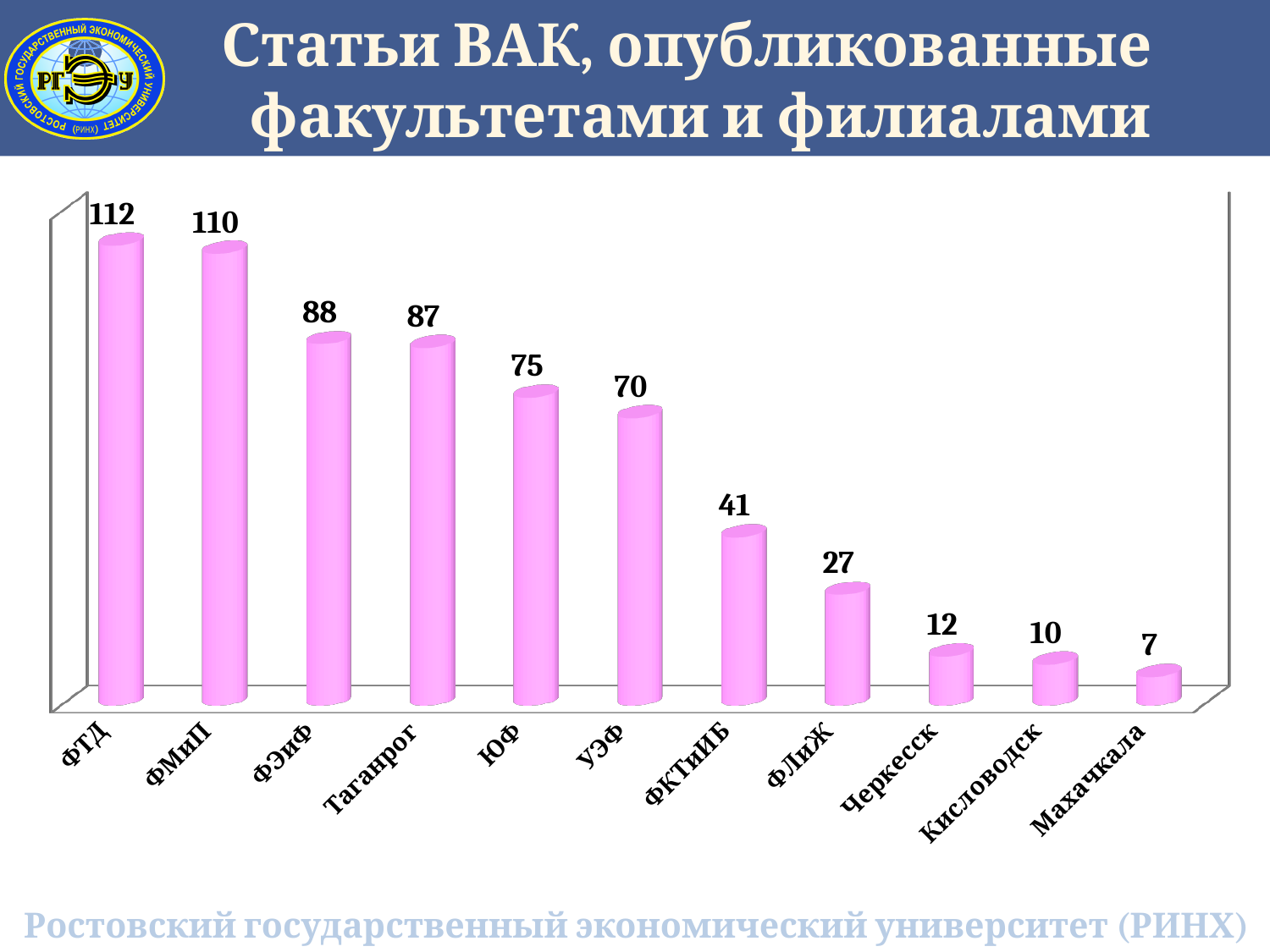
Do the values rise or fall from left to right along the x axis? fall Which category has the lowest value? Махачкала What is the value for ФТД? 112 Which is larger, the value for ФЛиЖ or the value for Черкесск? ФЛиЖ What is the value for ФКТиИБ? 41 How many categories are shown on the x axis? 11 What is the difference between the values for ФМиП and ФЭиФ? 22 Which category has the highest value? ФТД What is the value for Таганрог? 87 What is the value for Кисловодск? 10 What is the difference between the values for ЮФ and УЭФ? 5 What kind of chart is shown on the slide? bar chart